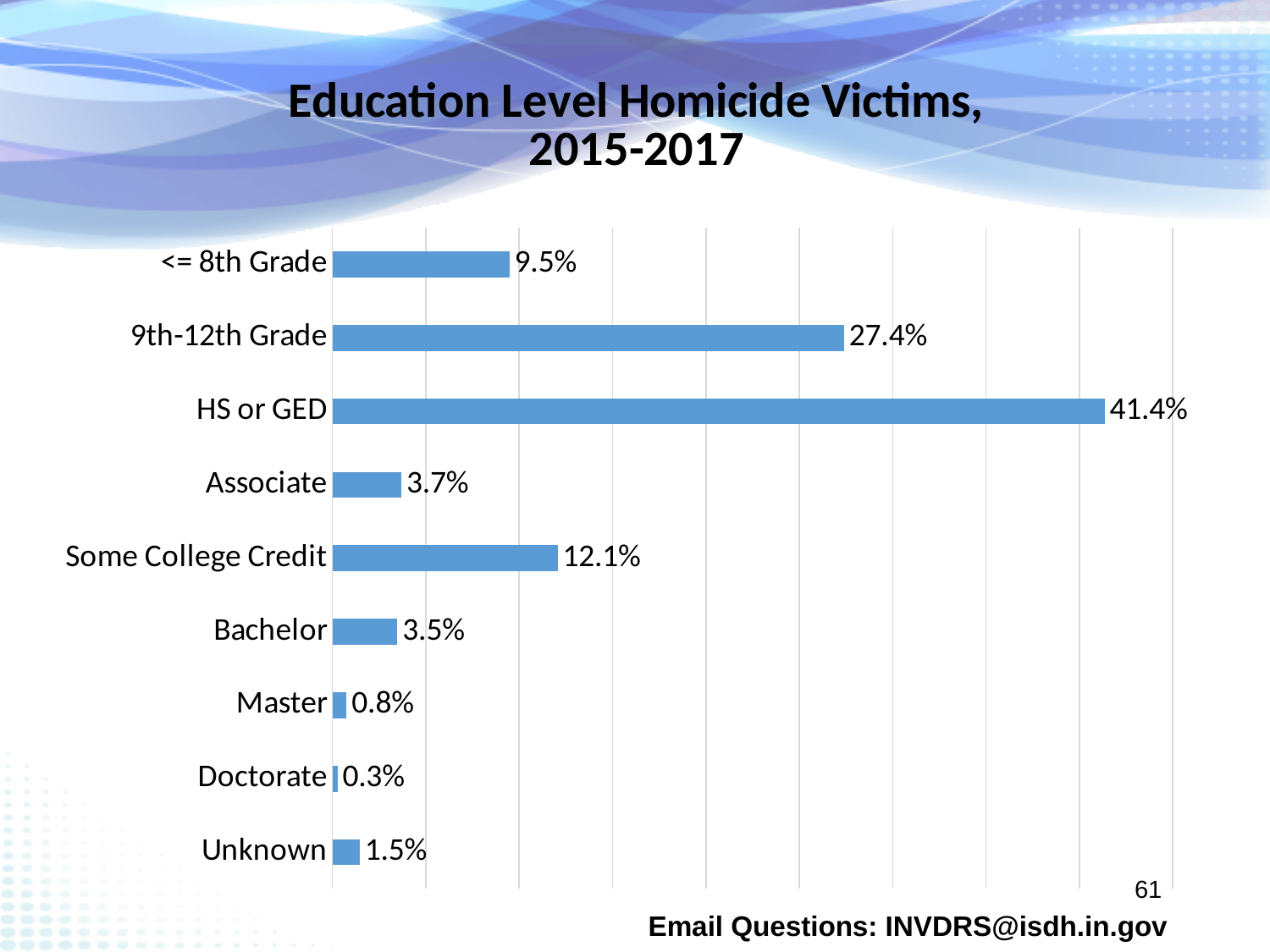
What type of chart is shown on the slide? Bar chart Which education level has the highest percentage? HS or GED Which is larger, the value for Associate or the value for Bachelor? Associate How many education level categories are shown in the chart? 9 What percentage of homicide victims had HS or GED education level? 41.4% Which education level has the lowest percentage? Doctorate What percentage is shown for 9th-12th Grade? 27.4% What is the title of the chart? Education Level Homicide Victims, 2015-2017 What is the value for Some College Credit? 12.1% What is the value for Doctorate? 0.3% What is the difference between the Some College Credit value and the <= 8th Grade value? 2.6% What is the difference between the HS or GED value and the 9th-12th Grade value? 14.0%